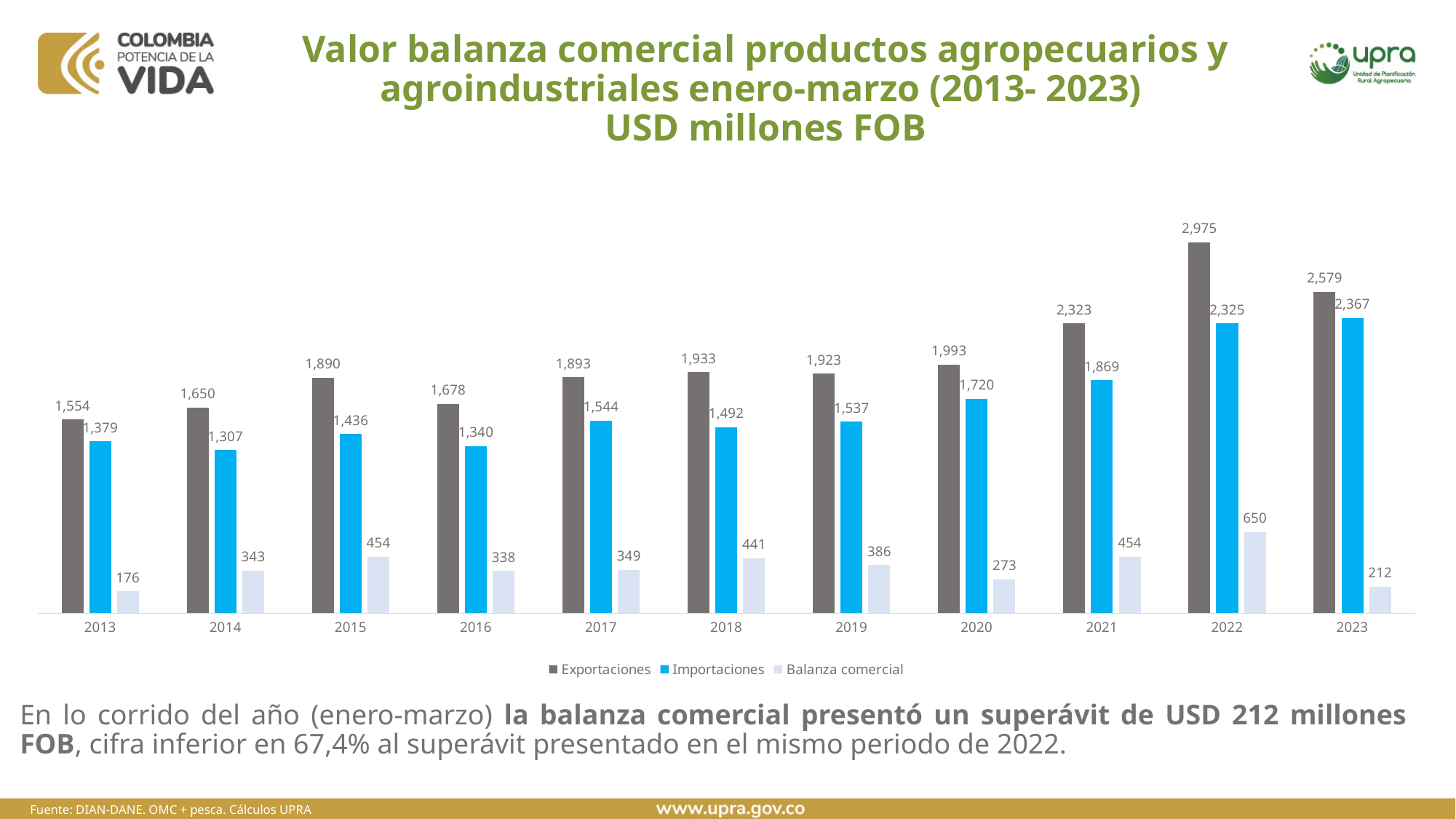
How many series does the legend list? 3 Did Exportaciones rise or fall from 2022 to 2023? Fall What is the value of Exportaciones for 2022? 2,975 What kind of chart is shown on the slide? Bar chart What is the value of Importaciones for 2016? 1,340 What is the difference between Exportaciones and Importaciones in 2023? 212 Which year has the lowest Exportaciones? 2013 Which is larger, Importaciones in 2021 or Importaciones in 2020? Importaciones in 2021 Which year has the highest Balanza comercial? 2022 How many years are shown on the x axis? 11 Which series is shown in light blue? Importaciones What is the value of Balanza comercial for 2018? 441